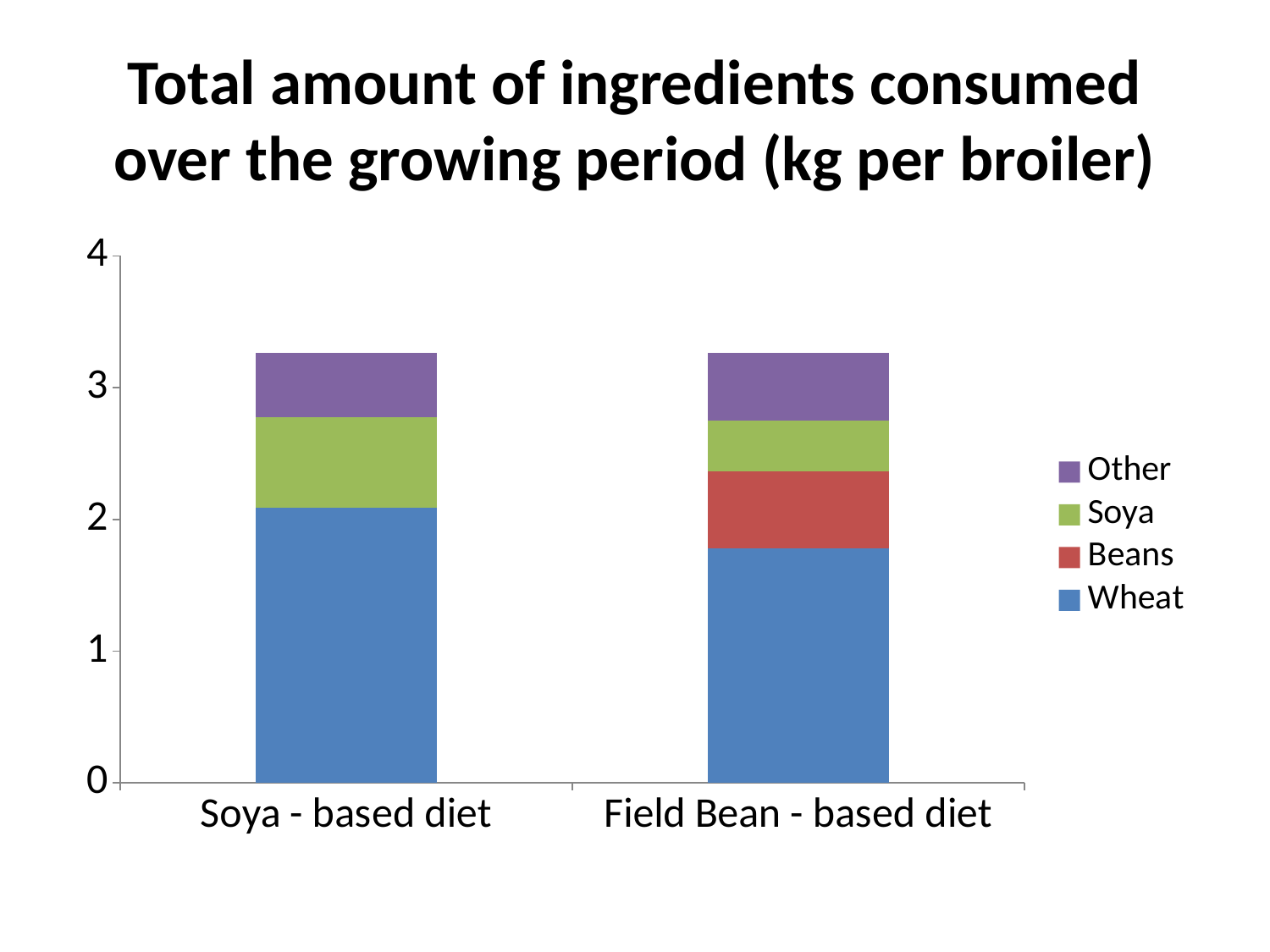
Which diet has the larger Soya segment? Soya - based diet How many diet categories are shown on the x axis? 2 Is the Wheat value for the Soya - based diet greater or less than 1? greater Is the total height of the Field Bean - based diet bar greater or less than 4? less Which ingredient makes up the largest segment in both bars? Wheat Is the Wheat value for the Field Bean - based diet greater or less than 2? less How many series does the legend list? 4 Which ingredients are listed in the legend? Other, Soya, Beans, Wheat What kind of chart is shown on the slide? Stacked bar chart Which diet has the larger Wheat segment? Soya - based diet Which ingredient appears only in the Field Bean - based diet bar? Beans